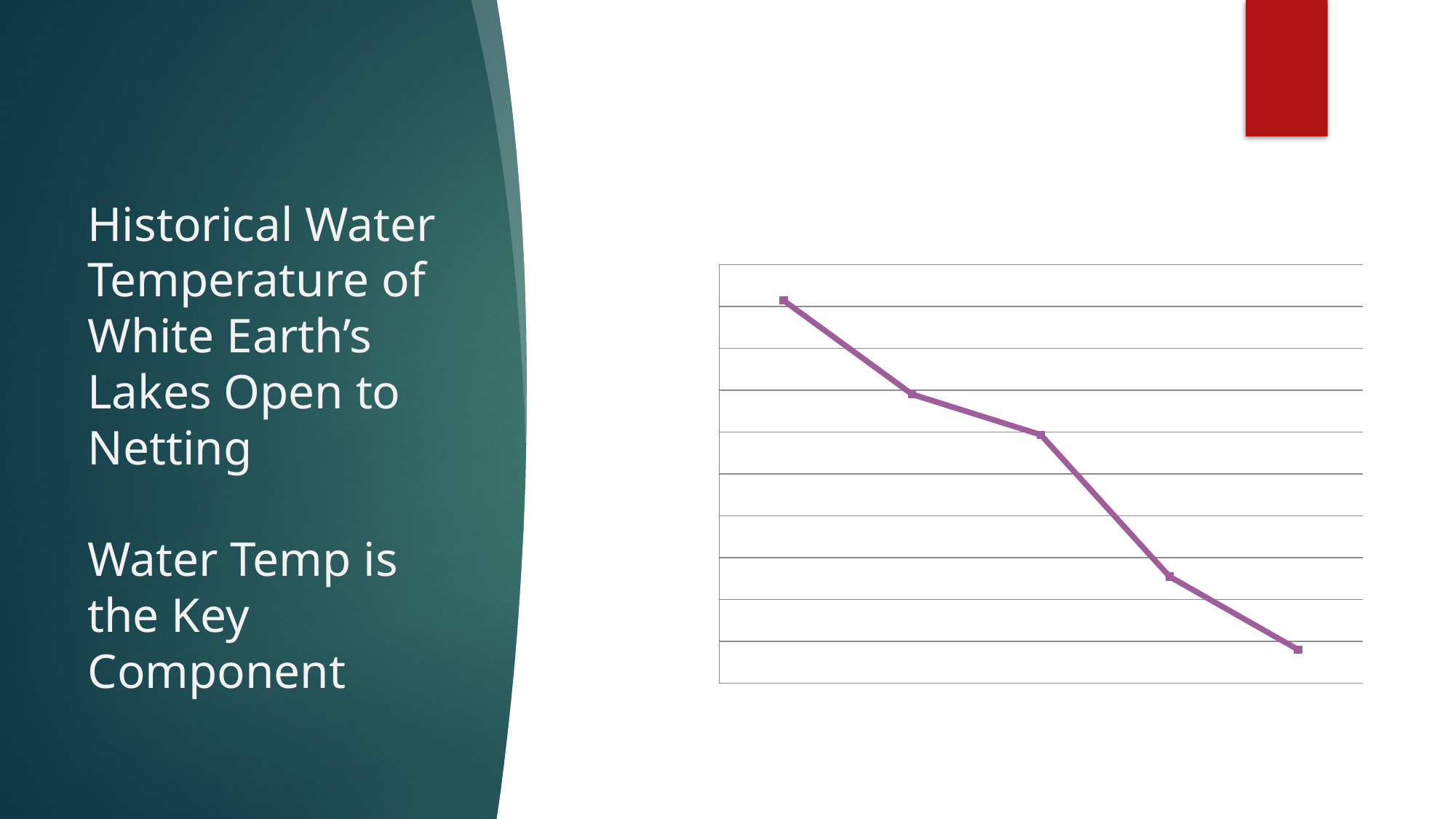
Does the chart display a legend? No How many lines (series) are plotted in the chart? 1 Which point on the line is the highest: the leftmost or the rightmost? leftmost What colour is the line plotted in the chart? purple Do the plotted values rise or fall from left to right along the x axis of the chart? fall Is the first (leftmost) point on the line higher or lower than the last (rightmost) point? higher What kind of chart is shown on the slide? line chart Which point on the line is the lowest: the leftmost or the rightmost? rightmost How many data points are plotted on the line in the chart? 5